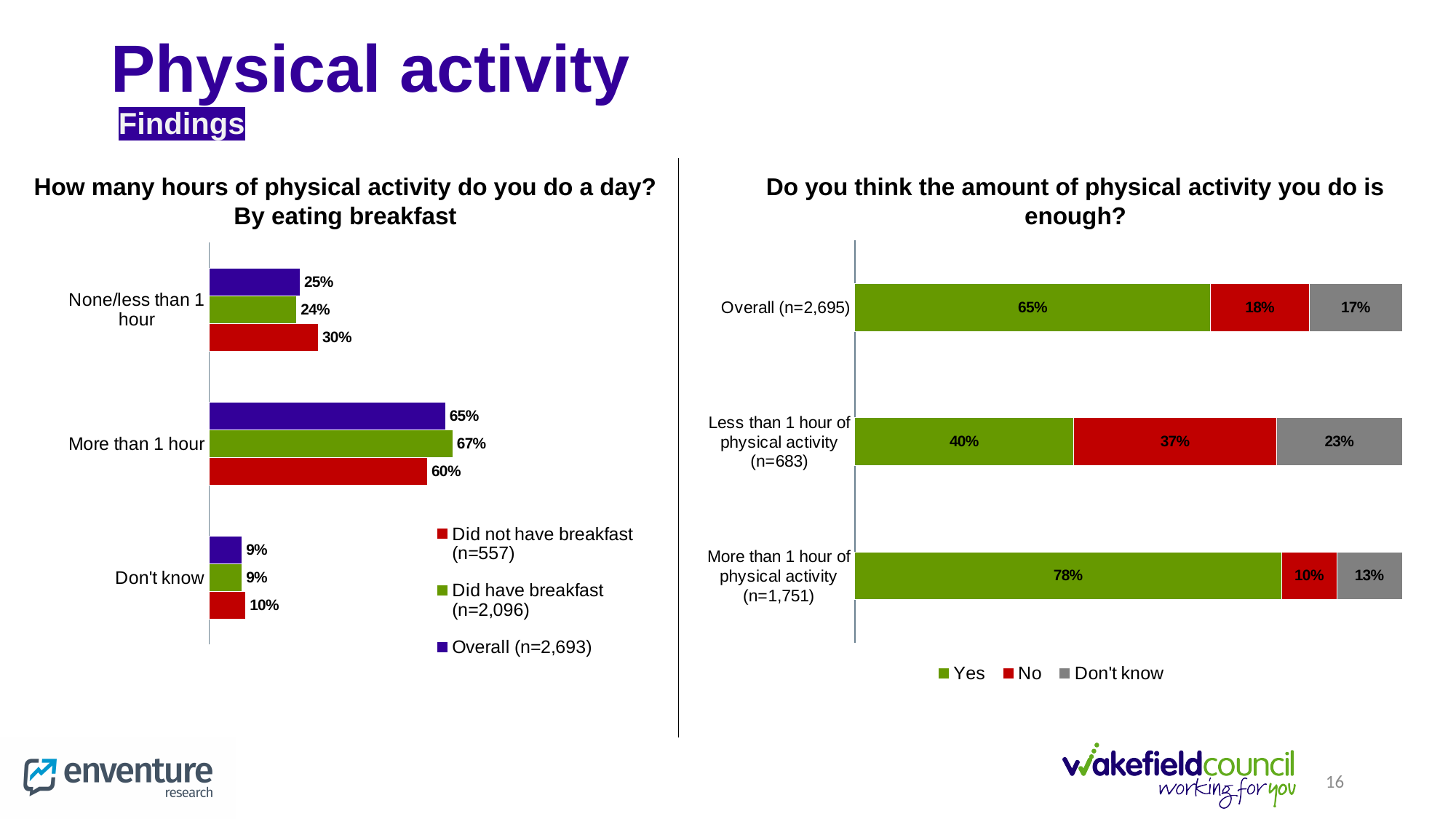
In the right chart 'Do you think the amount of physical activity you do is enough?', what is the 'Yes' value for 'More than 1 hour of physical activity (n=1,751)'? 78% In the left chart 'How many hours of physical activity do you do a day? By eating breakfast', how many categories are shown? 3 In the left chart 'How many hours of physical activity do you do a day? By eating breakfast', what is the value for 'Did have breakfast' in the 'More than 1 hour' category? 67% In the right chart 'Do you think the amount of physical activity you do is enough?', what is the 'No' value for 'Less than 1 hour of physical activity (n=683)'? 37% In the left chart 'How many hours of physical activity do you do a day? By eating breakfast', what is the difference between 'Did have breakfast' and 'Did not have breakfast' in the 'More than 1 hour' category? 7 percentage points In the right chart 'Do you think the amount of physical activity you do is enough?', is the 'Don't know' value larger for 'Overall (n=2,695)' or for 'Less than 1 hour of physical activity (n=683)'? Less than 1 hour of physical activity (n=683) In the left chart 'How many hours of physical activity do you do a day? By eating breakfast', which category has the highest value for the 'Overall' series? More than 1 hour In the right chart 'Do you think the amount of physical activity you do is enough?', what is the total of the stacked bar for 'Overall (n=2,695)'? 100% In the left chart 'How many hours of physical activity do you do a day? By eating breakfast', how many series does the legend list? 3 What kind of chart is the right chart 'Do you think the amount of physical activity you do is enough?'? Stacked bar chart In the right chart 'Do you think the amount of physical activity you do is enough?', which category has the lowest 'Yes' value? Less than 1 hour of physical activity (n=683) In the left chart 'How many hours of physical activity do you do a day? By eating breakfast', what is the value for 'Did not have breakfast' in the 'None/less than 1 hour' category? 30%